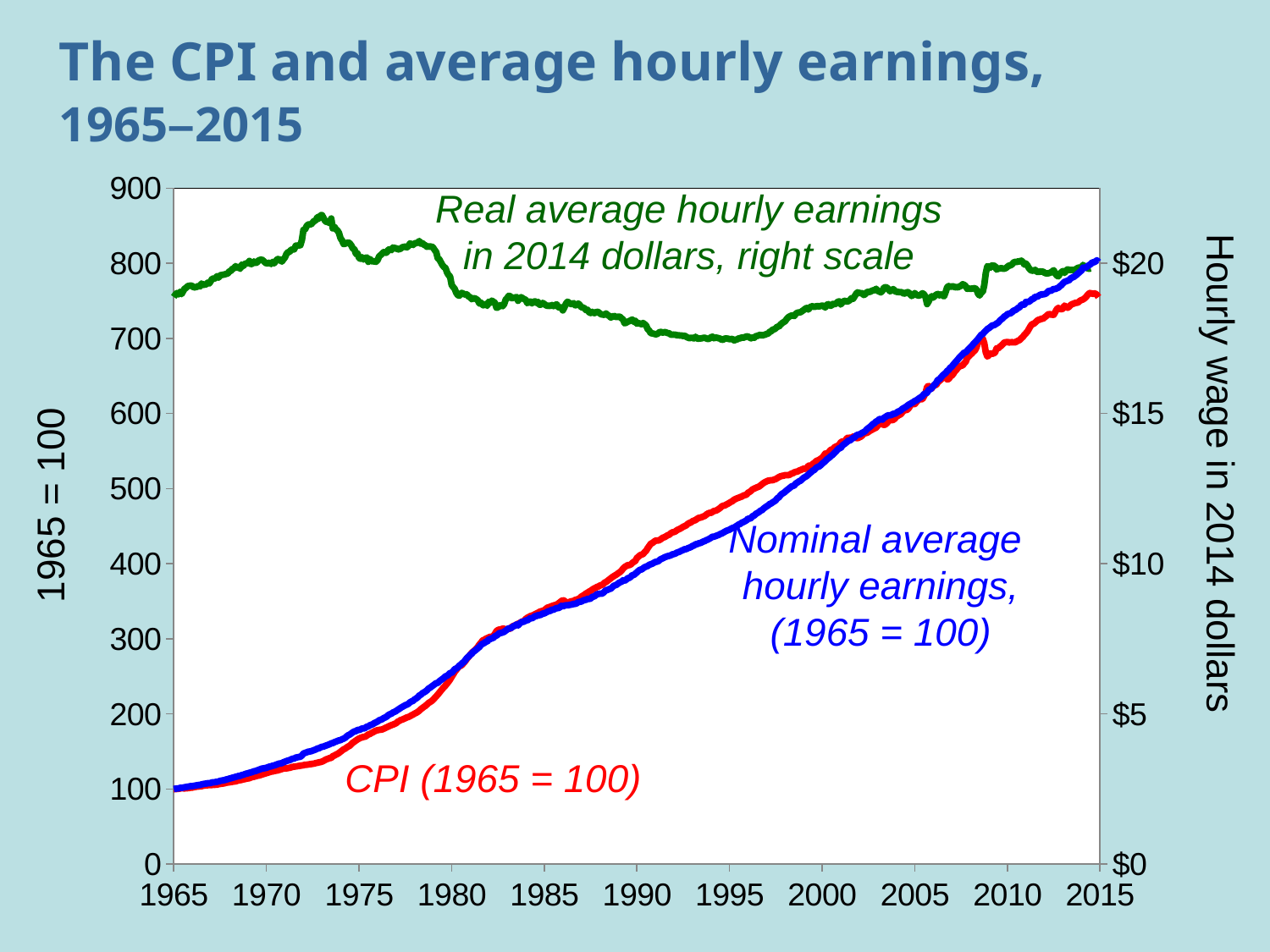
Is the value of the CPI (1965 = 100) series in 1985 greater or less than 400? less Is the value of the CPI (1965 = 100) series in 2015 greater or less than 700? greater Is the value of the Nominal average hourly earnings series in 2015 greater or less than 700? greater In 1995, which is larger: the CPI (1965 = 100) or the Nominal average hourly earnings (1965 = 100)? CPI (1965 = 100) How many data series are plotted on the chart? 3 What kind of chart is shown on the slide? line chart What is the value of the Nominal average hourly earnings (1965 = 100) series in 1965? 100 In 2015, which is larger: the CPI (1965 = 100) or the Nominal average hourly earnings (1965 = 100)? Nominal average hourly earnings (1965 = 100) Does the CPI (1965 = 100) series rise or fall from 1965 to 2015? rise What is the value of the CPI (1965 = 100) series in 1965? 100 What is the title of the right-hand vertical axis? Hourly wage in 2014 dollars